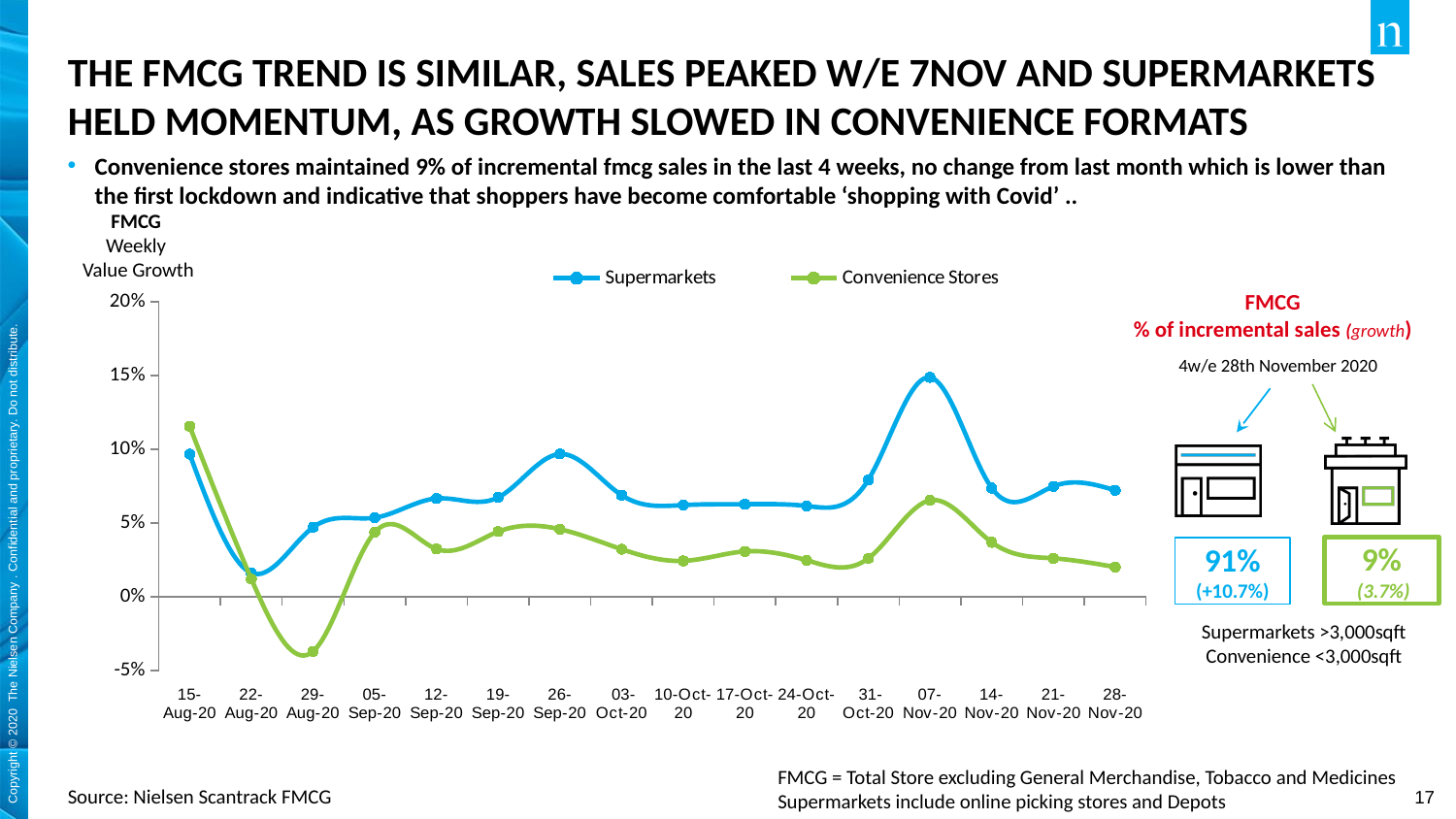
At which week does the Supermarkets line reach its highest value? 07-Nov-20 What kind of chart is shown on the slide? Line chart At which week does the Convenience Stores line reach its highest value? 15-Aug-20 At which week does the Convenience Stores line reach its lowest value? 29-Aug-20 Is the Supermarkets value for 07-Nov-20 greater or less than 10%? greater How many weekly dates are shown along the x axis of the chart? 16 Is the Supermarkets value for 22-Aug-20 greater or less than 5%? less Does the Supermarkets line rise or fall between 07-Nov-20 and 28-Nov-20? Fall At 07-Nov-20, which series has the higher value, Supermarkets or Convenience Stores? Supermarkets How many series does the chart legend list? 2 Which two series are shown in the chart legend? Supermarkets and Convenience Stores Is the Convenience Stores value for 29-Aug-20 greater or less than 0%? less